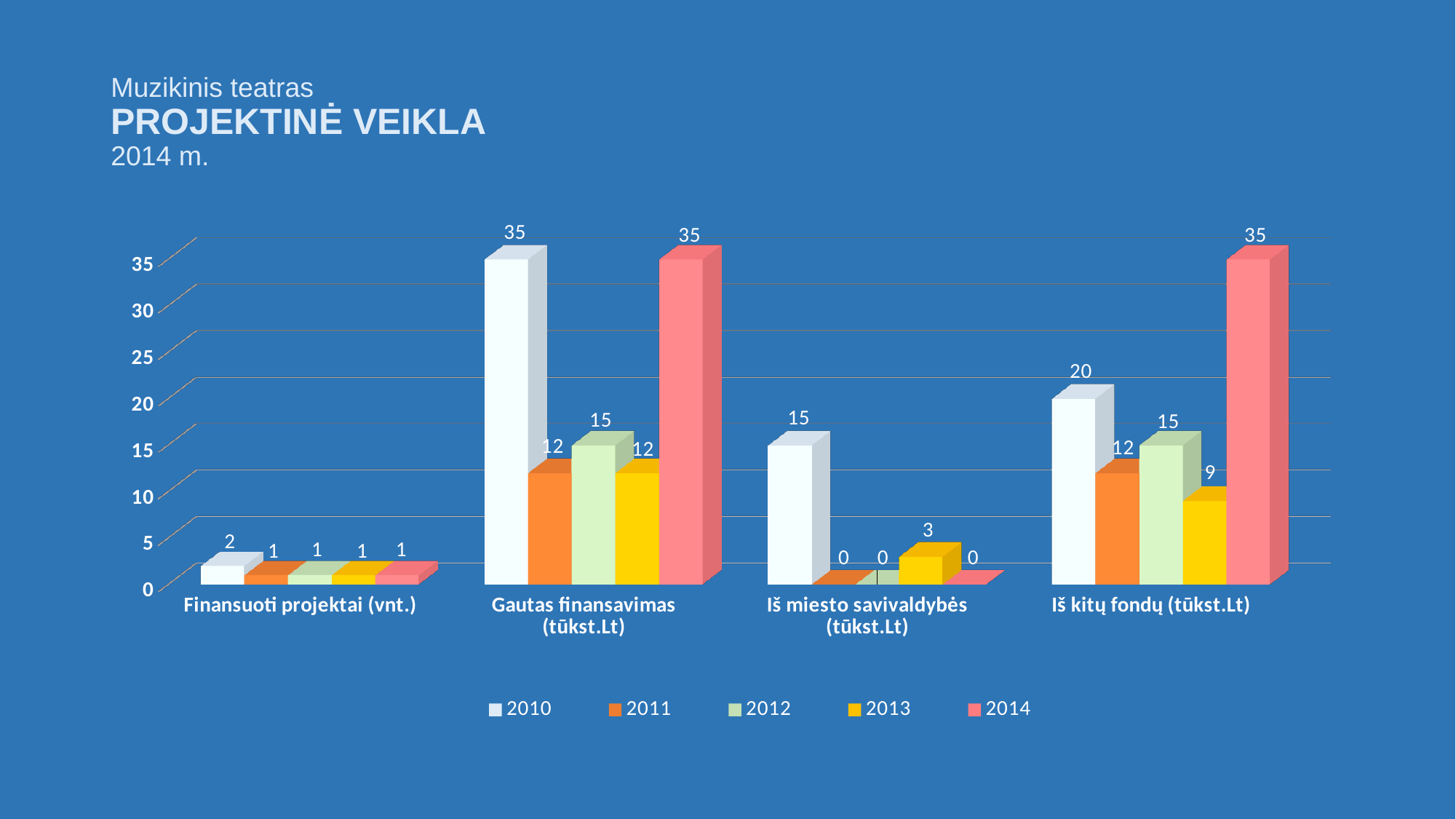
Which legend entry is shown in yellow? 2013 Which year has the highest value in the 'Iš kitų fondų (tūkst.Lt)' category? 2014 What kind of chart is shown on the slide? Bar chart What is the difference between the 2010 and 2011 values in the 'Iš kitų fondų (tūkst.Lt)' category? 8 In the 'Gautas finansavimas (tūkst.Lt)' category, which is larger: the value for 2012 or the value for 2013? 2012 What is the value for 2013 in the 'Iš miesto savivaldybės (tūkst.Lt)' category? 3 How many series does the legend list? 5 What is the value for 2010 in the 'Finansuoti projektai (vnt.)' category? 2 Which year has the lowest value in the 'Iš kitų fondų (tūkst.Lt)' category? 2013 What is the value for 2013 in the 'Iš kitų fondų (tūkst.Lt)' category? 9 How many categories are shown on the x axis? 4 What is the value for 2014 in the 'Gautas finansavimas (tūkst.Lt)' category? 35